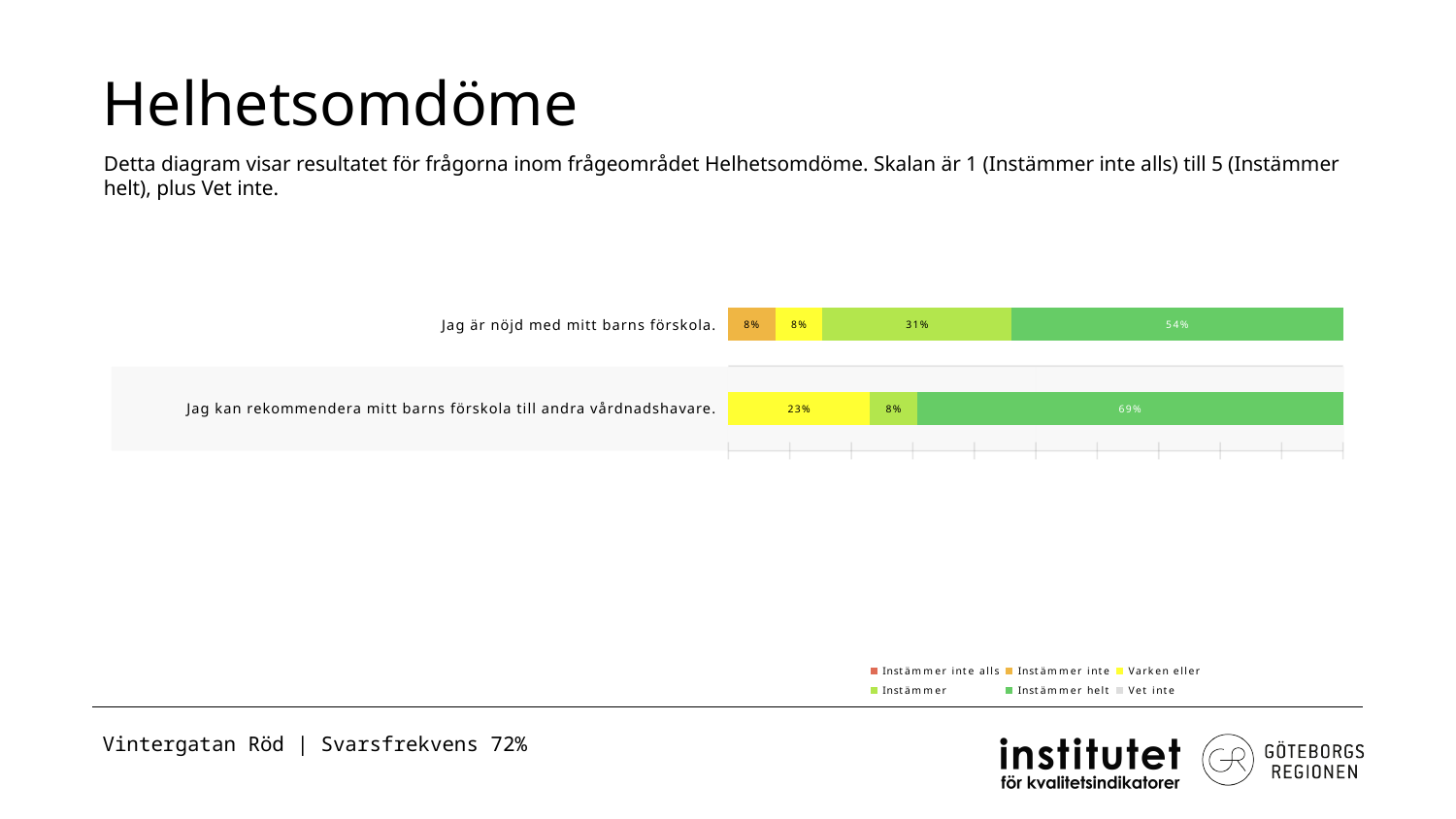
How many response categories does the legend list? 6 What percentage of respondents answered "Instämmer helt" for "Jag kan rekommendera mitt barns förskola till andra vårdnadshavare."? 69% What type of chart is shown on the slide? Stacked bar chart What is the "Instämmer inte" share for "Jag är nöjd med mitt barns förskola."? 8% What is the difference in the "Instämmer helt" share between the two statements? 15 percentage points What is the "Varken eller" share for "Jag kan rekommendera mitt barns förskola till andra vårdnadshavare."? 23% What is the "Instämmer" share for "Jag är nöjd med mitt barns förskola."? 31% How many statements (bars) are shown in the chart? 2 Which response category is the largest segment in the bar for "Jag är nöjd med mitt barns förskola."? Instämmer helt What is the total of the labelled segments in the bar for "Jag kan rekommendera mitt barns förskola till andra vårdnadshavare."? 100% What percentage of respondents answered "Instämmer helt" for "Jag är nöjd med mitt barns förskola."? 54% Which statement has the larger "Instämmer helt" share? Jag kan rekommendera mitt barns förskola till andra vårdnadshavare.